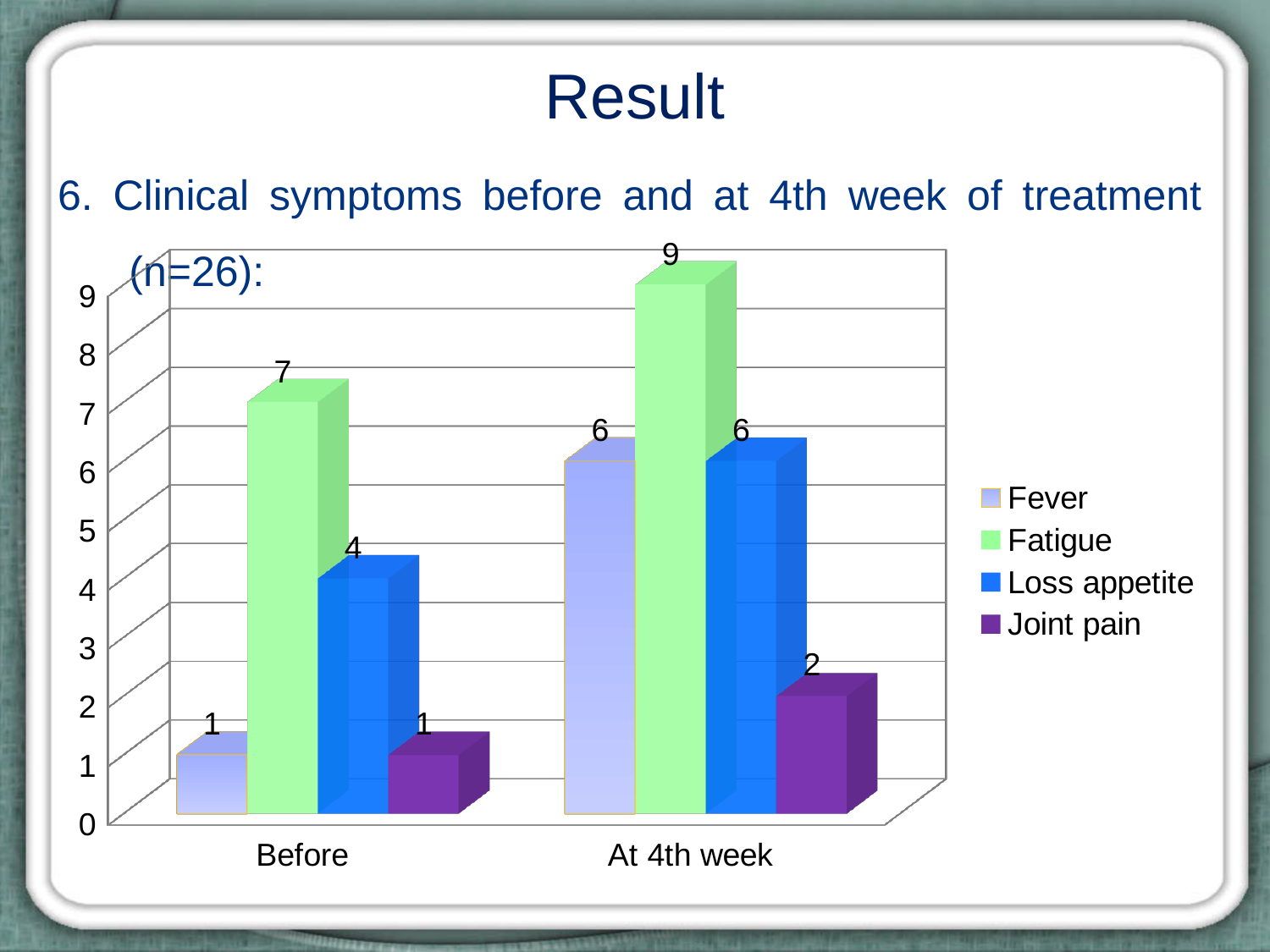
Which colour represents Joint pain in the legend? Purple What is the difference between the Fatigue values at 4th week and Before? 2 What is the value for Fatigue in the Before category? 7 How many categories are shown on the x axis? 2 What is the value for Fever at 4th week? 6 What is the value for Loss appetite at 4th week? 6 Which is larger: Fever at 4th week or Loss appetite Before? Fever at 4th week What is the value for Joint pain in the Before category? 1 How many series does the legend list? 4 What kind of chart is shown on the slide? Bar chart Which symptom has the lowest value at 4th week? Joint pain Which symptom has the highest value at 4th week? Fatigue